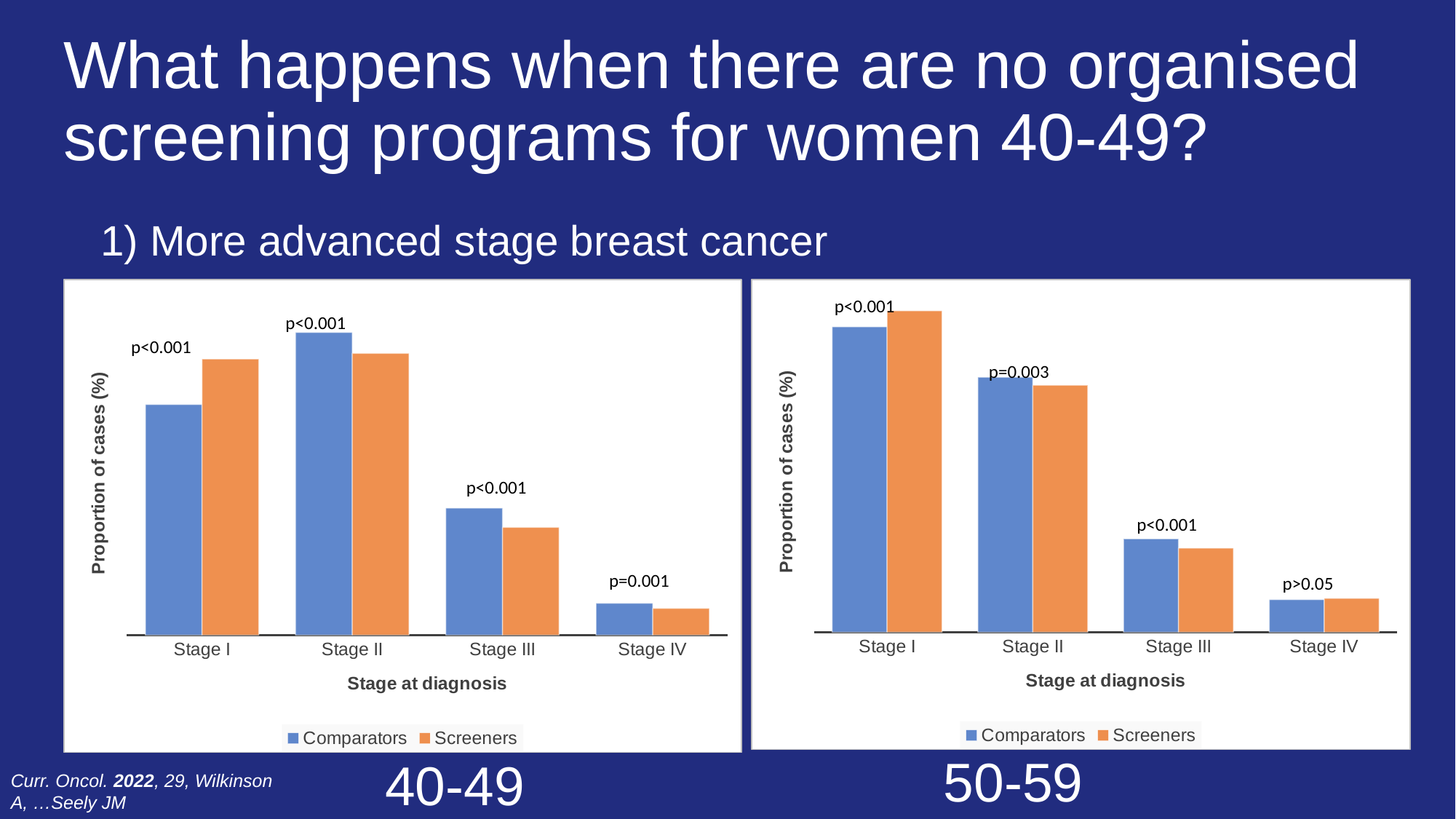
In the 40-49 chart, at Stage I, which is larger: Comparators or Screeners? Screeners In the 50-59 chart, how many series does the legend list? 2 In the 40-49 chart, which stage has the highest Comparators bar? Stage II In the 40-49 chart, which stage has the lowest Screeners bar? Stage IV In the 50-59 chart, what p-value is printed above the Stage II bars? p=0.003 In the 40-49 chart, how many stage categories are shown on the x axis? 4 In the 40-49 chart, what is the title of the y axis? Proportion of cases (%) In the 50-59 chart, at Stage II, which is larger: Comparators or Screeners? Comparators In the 50-59 chart, do the Comparators values rise or fall from Stage I to Stage IV? Fall In the 40-49 chart, at Stage III, which is larger: Comparators or Screeners? Comparators In the 50-59 chart, which stage has the highest Screeners bar? Stage I What kind of chart is the 40-49 chart on the left? Bar chart